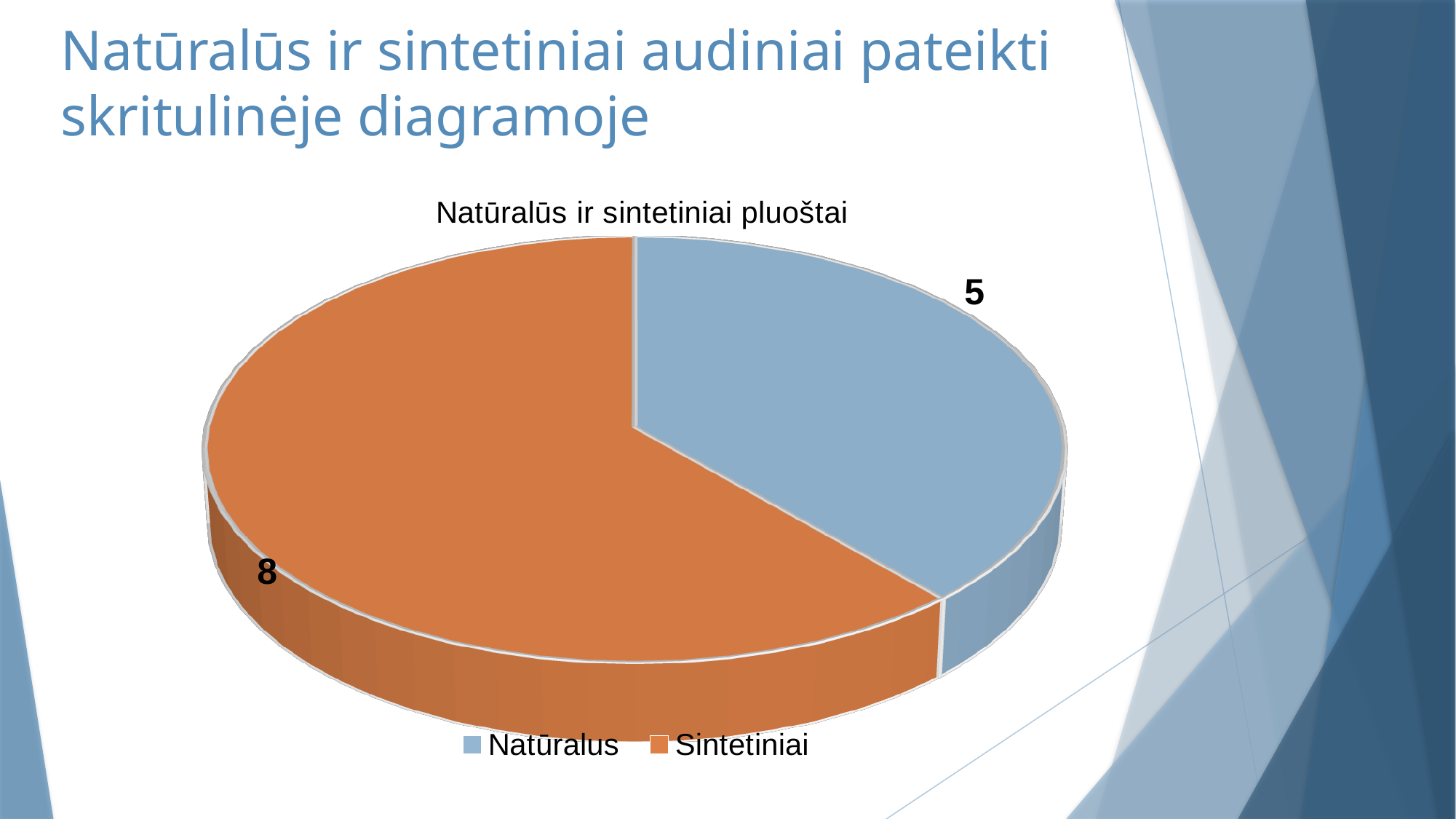
What is the value for Natūralus? 5 What is the value for Sintetiniai? 8 What is the title of the chart? Natūralūs ir sintetiniai pluoštai Which category has the smallest slice? Natūralus Which category has the largest slice? Sintetiniai What is the total of the two slice values? 13 How many entries does the legend list? 2 What type of chart is shown on the slide? Pie chart Which is larger, the value for Natūralus or the value for Sintetiniai? Sintetiniai What is the difference between the values for Sintetiniai and Natūralus? 3 Which colour represents Sintetiniai in the chart? Orange How many slices does the pie chart have? 2